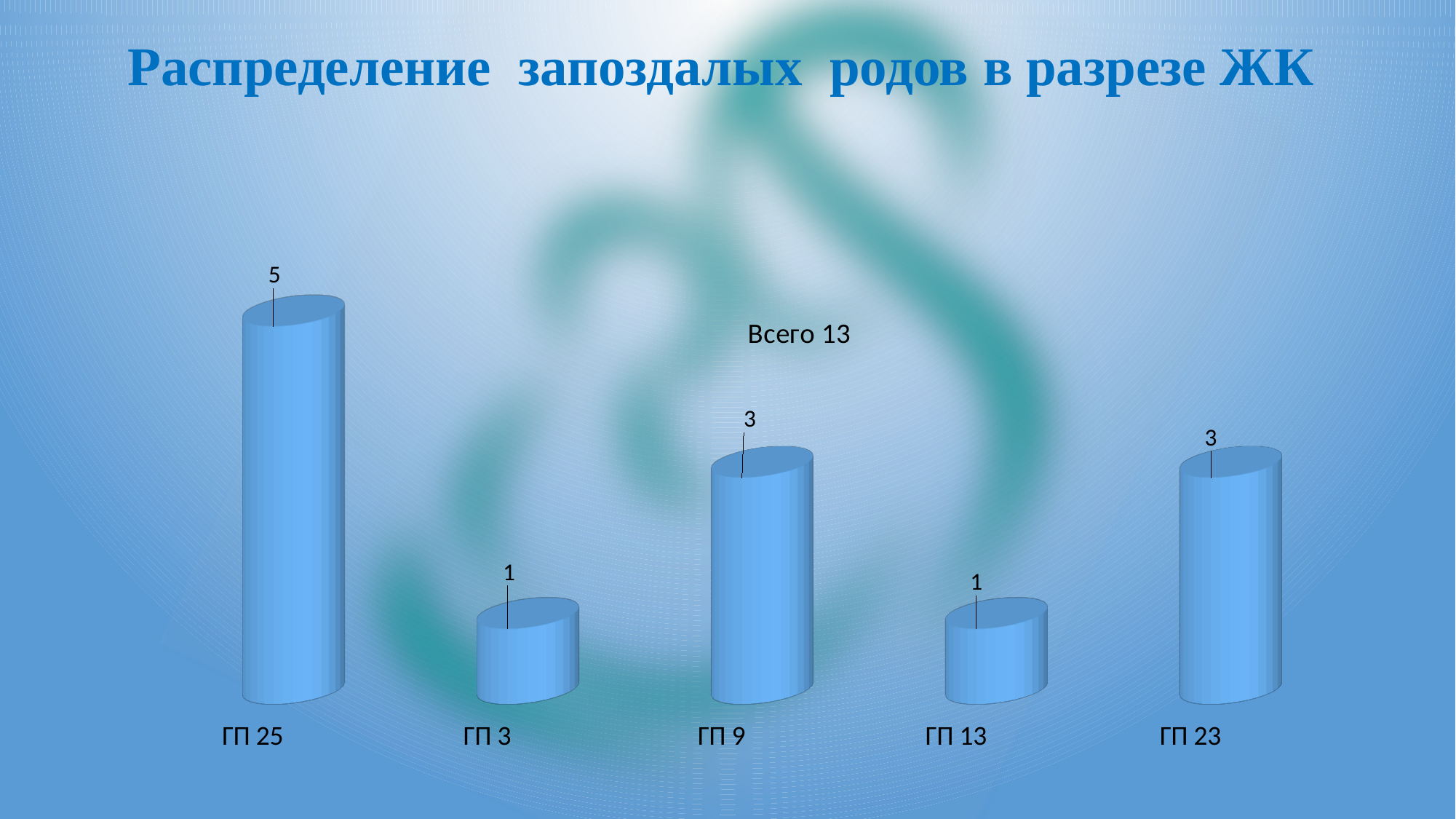
What kind of chart is shown on the slide? bar chart What is the difference between the values for ГП 25 and ГП 3? 4 What is the value for ГП 23? 3 What is the title of the slide? Распределение запоздалых родов в разрезе ЖК What is the value for ГП 9? 3 What is the value for ГП 25? 5 Which category has the highest value? ГП 25 What total is stated on the chart (Всего)? 13 What is the difference between the values for ГП 9 and ГП 13? 2 How many categories are shown in the chart? 5 What is the value for ГП 13? 1 Which is larger, the value for ГП 23 or the value for ГП 3? ГП 23